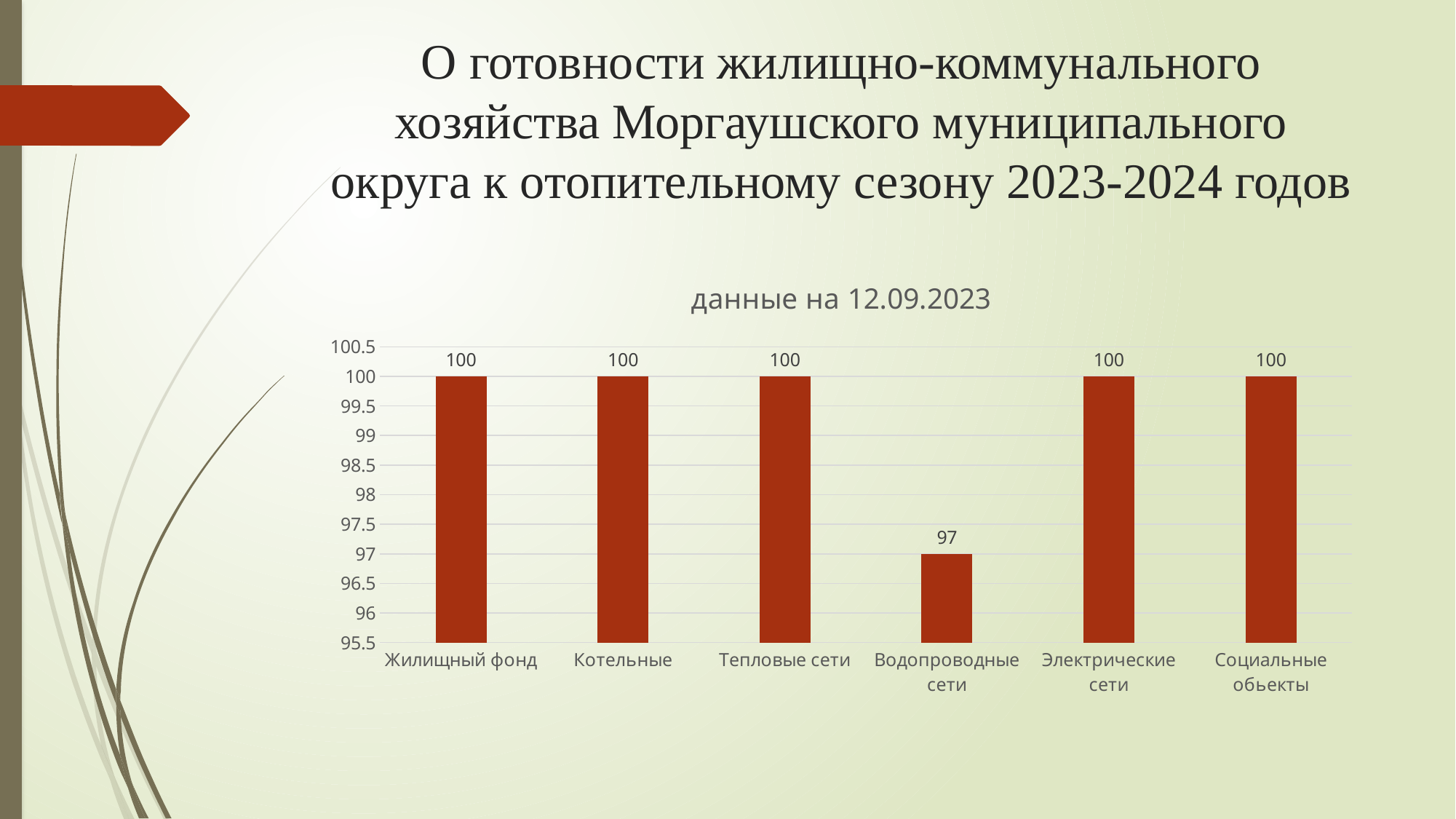
What colour are the bars in the chart? red Which category has the lowest value? Водопроводные сети How many categories have a value of 100? 5 What kind of chart is shown on the slide? bar chart Which is larger, the value for Электрические сети or the value for Водопроводные сети? Электрические сети What is the value for Водопроводные сети? 97 What is the value for Жилищный фонд? 100 What is the value for Котельные? 100 How many categories are shown on the x axis? 6 What is the title of the chart? данные на 12.09.2023 Is the value for Водопроводные сети greater or less than 98? less What is the difference between the value for Тепловые сети and the value for Водопроводные сети? 3